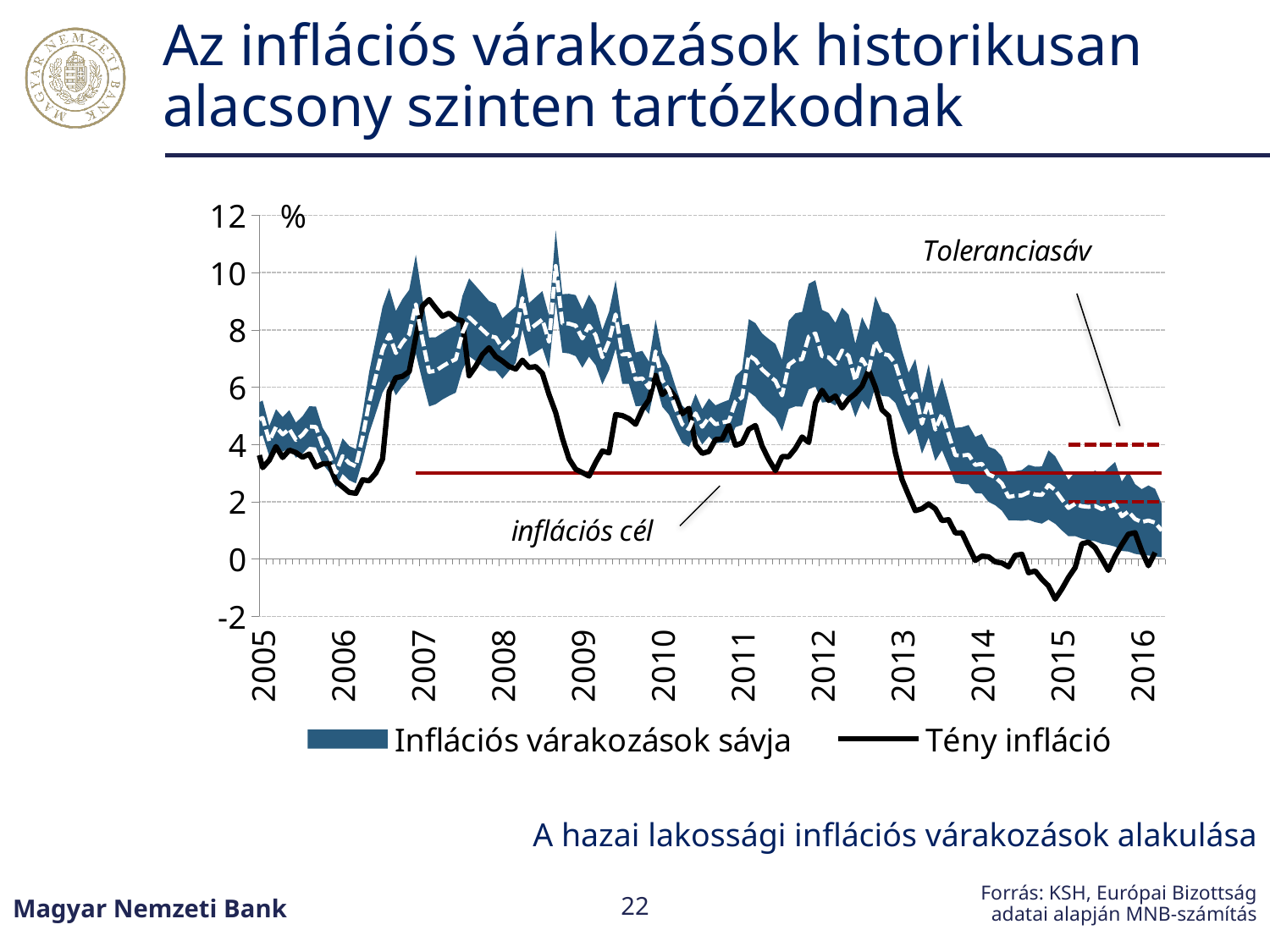
Which is higher in 2009: the Inflációs várakozások sávja or Tény infláció? Inflációs várakozások sávja How many series does the legend list? 2 Is the Inflációs várakozások sávja in 2008 greater or less than 6? greater What unit is shown on the vertical axis of the chart? % Is the lowest value of Tény infláció around 2015 greater or less than 0? less How many year labels are shown on the horizontal axis? 12 Does the Inflációs várakozások sávja rise or fall between 2013 and 2016? fall What kind of chart is shown on the slide? line chart At what levels are the two dashed lines of the 'Toleranciasáv' drawn? 2 and 4 What are the two entries in the chart legend? Inflációs várakozások sávja; Tény infláció Is the value of Tény infláció at its peak in early 2007 greater or less than 8? greater At what level is the solid red 'inflációs cél' line drawn? 3